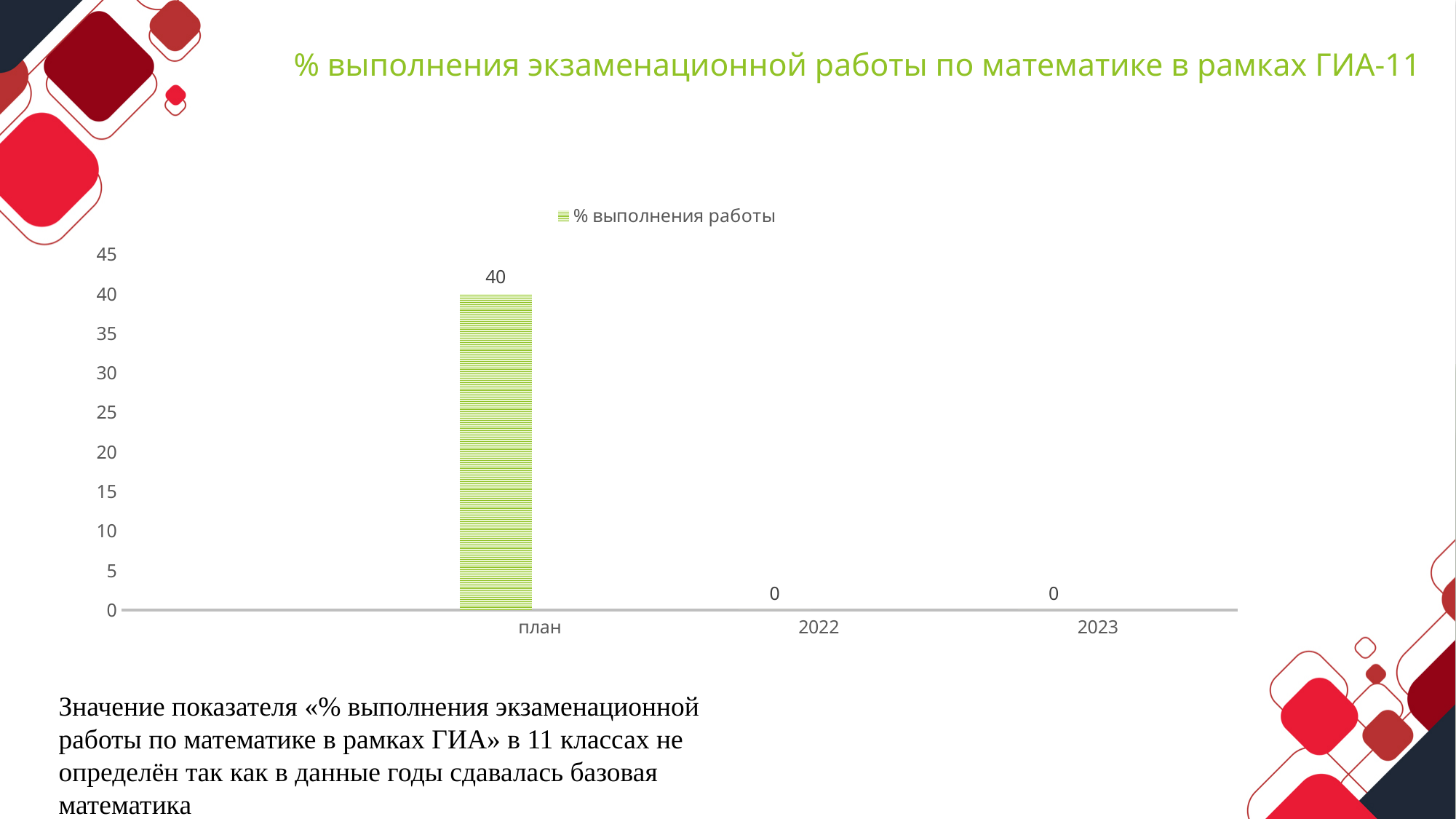
How many series does the legend list? 1 What is the value for 2022? 0 What is the value for план? 40 Which is larger, the value for план or the value for 2023? план Which category has the highest value? план What is the difference between the value for план and the value for 2022? 40 What is the value for 2023? 0 What is the maximum value shown on the vertical axis? 45 How many categories are shown on the x axis? 3 What is the name of the series in the legend? % выполнения работы Is the value for план greater or less than 35? greater What kind of chart is shown? bar chart